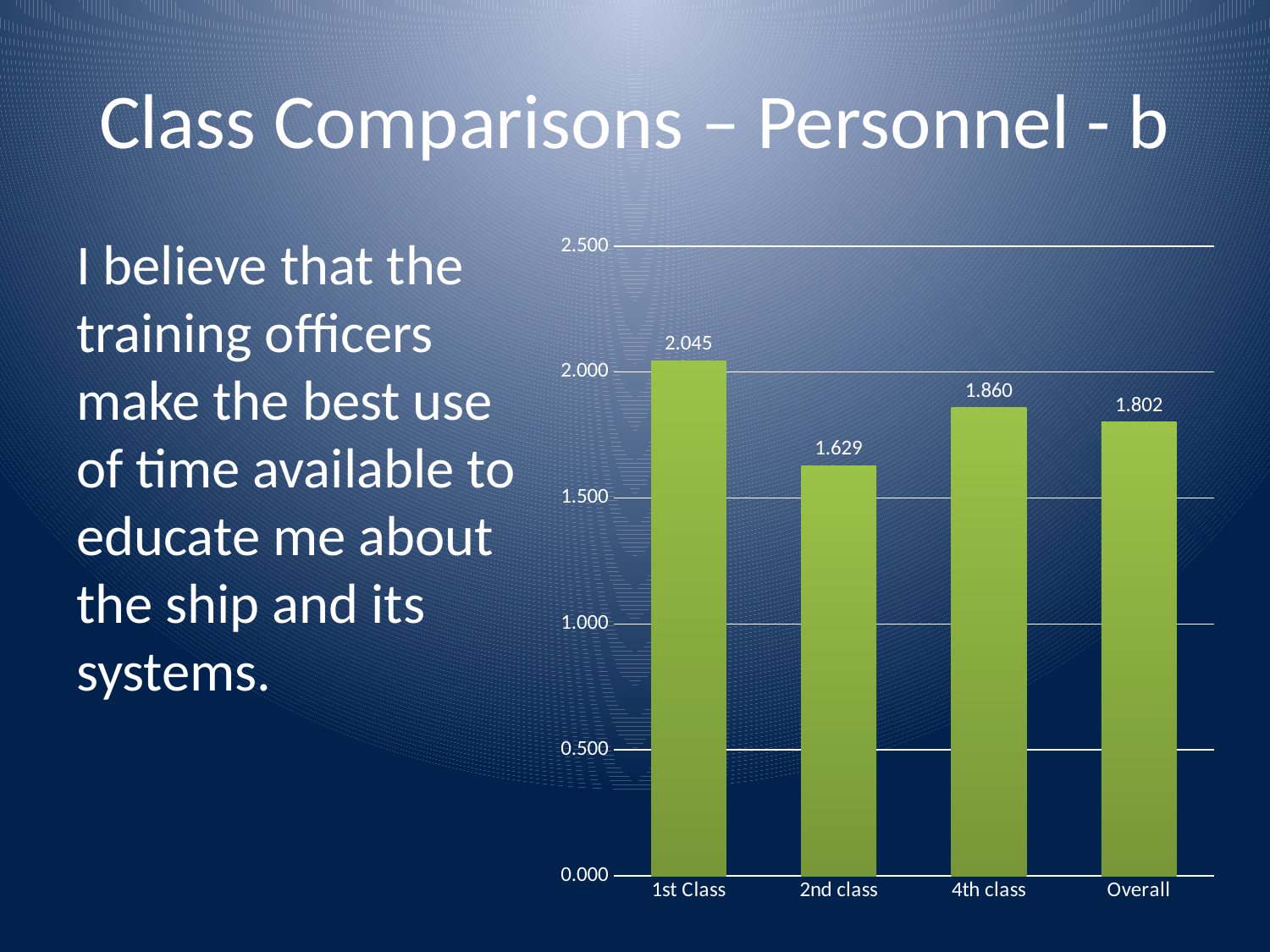
Which is larger, the value for 4th class or the value for 2nd class? 4th class What is the value for Overall? 1.802 What is the value for 1st Class? 2.045 Which category has the lowest value? 2nd class Which category has the highest value? 1st Class What kind of chart is shown on the slide? bar chart Is the value for 1st Class greater or less than 2.000? greater How many categories are shown on the x axis? 4 What is the difference between the values for 1st Class and 2nd class? 0.416 What is the value for 2nd class? 1.629 What is the difference between the values for 4th class and Overall? 0.058 What is the value for 4th class? 1.860